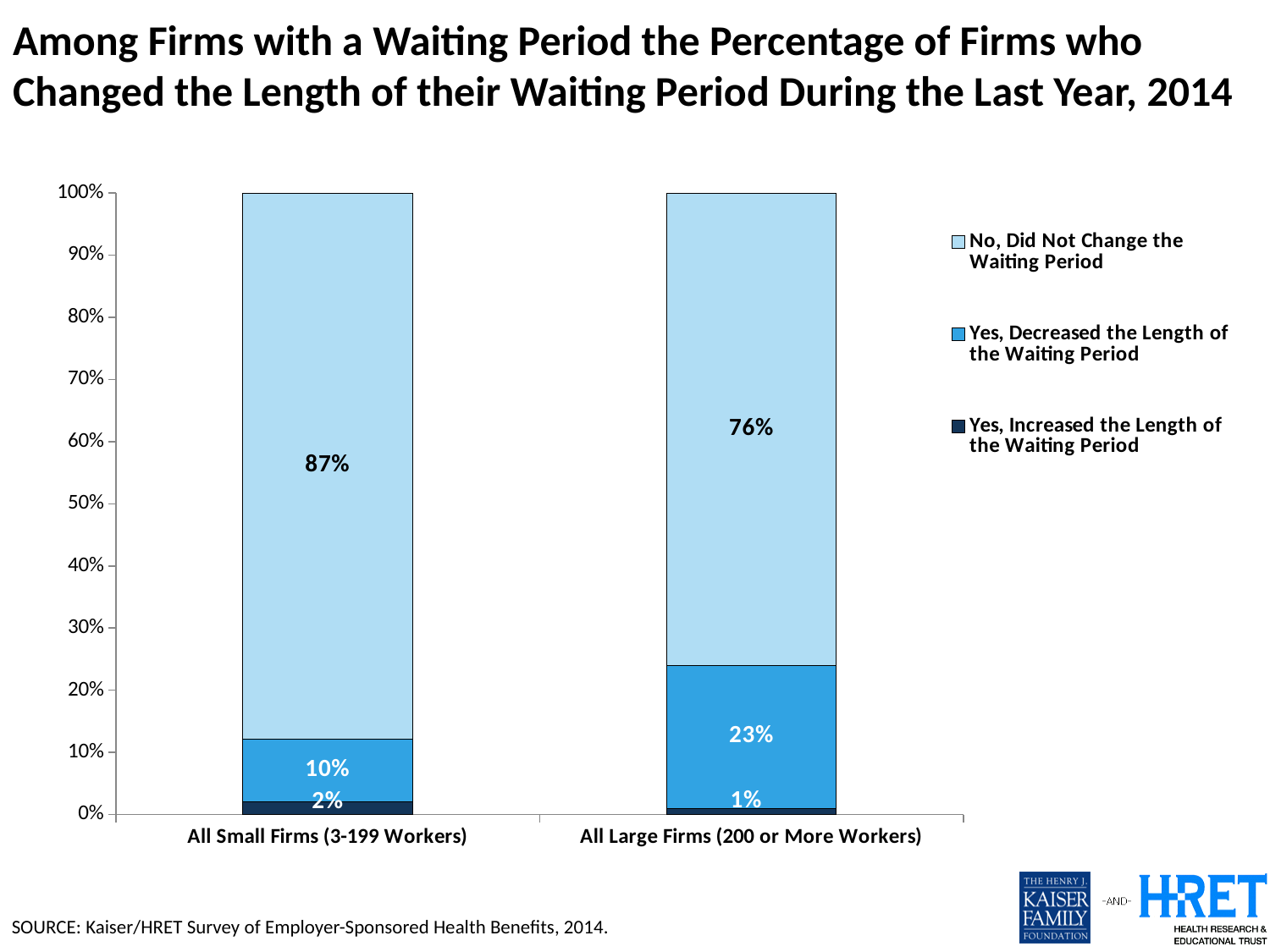
What is the difference between the percentage of large firms and small firms that decreased the length of the waiting period? 13 percentage points What percentage of all large firms (200 or more workers) decreased the length of the waiting period? 23% What is the total of the stacked bar for all small firms (3-199 workers)? 99% Which firm size category has the higher percentage of firms that decreased the length of the waiting period? All Large Firms (200 or More Workers) How many series does the legend list? 3 Which firm size category has the lower percentage of firms that increased the length of the waiting period? All Large Firms (200 or More Workers) What is the difference between the percentage of small firms and large firms that did not change the waiting period? 11 percentage points What percentage of all large firms (200 or more workers) did not change the waiting period? 76% What percentage of all small firms (3-199 workers) did not change the waiting period? 87% What percentage of all small firms (3-199 workers) increased the length of the waiting period? 2% What kind of chart is shown on the slide? Stacked bar chart How many firm size categories are shown on the x axis? 2